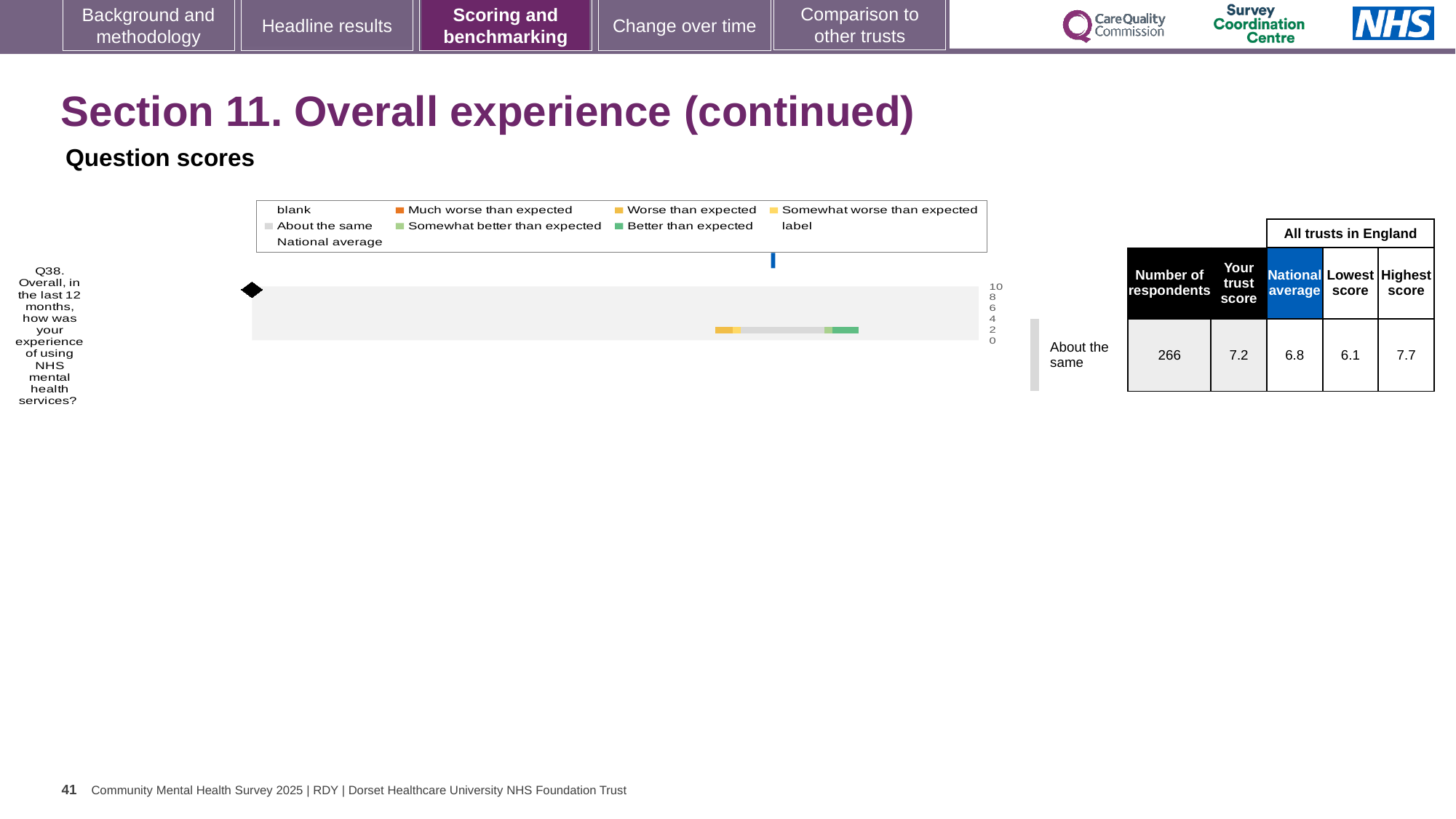
How many survey questions are plotted in the chart? 1 What kind of chart is shown on the slide? bar chart In the table beside the chart, what is the national average for Q38? 6.8 In the table beside the chart, what is the number of respondents for Q38? 266 Which is larger for Q38, your trust score or the national average? Your trust score What is the difference between the highest score and the lowest score for Q38 in the table? 1.6 In the table beside the chart, what is your trust score for Q38? 7.2 Which question is plotted in the chart? Q38. Overall, in the last 12 months, how was your experience of using NHS mental health services? What is the highest value shown on the chart's axis? 10 In the table beside the chart, what is the highest score among all trusts in England for Q38? 7.7 In the table beside the chart, what is the lowest score among all trusts in England for Q38? 6.1 What benchmark category is shown next to the chart for Q38? About the same